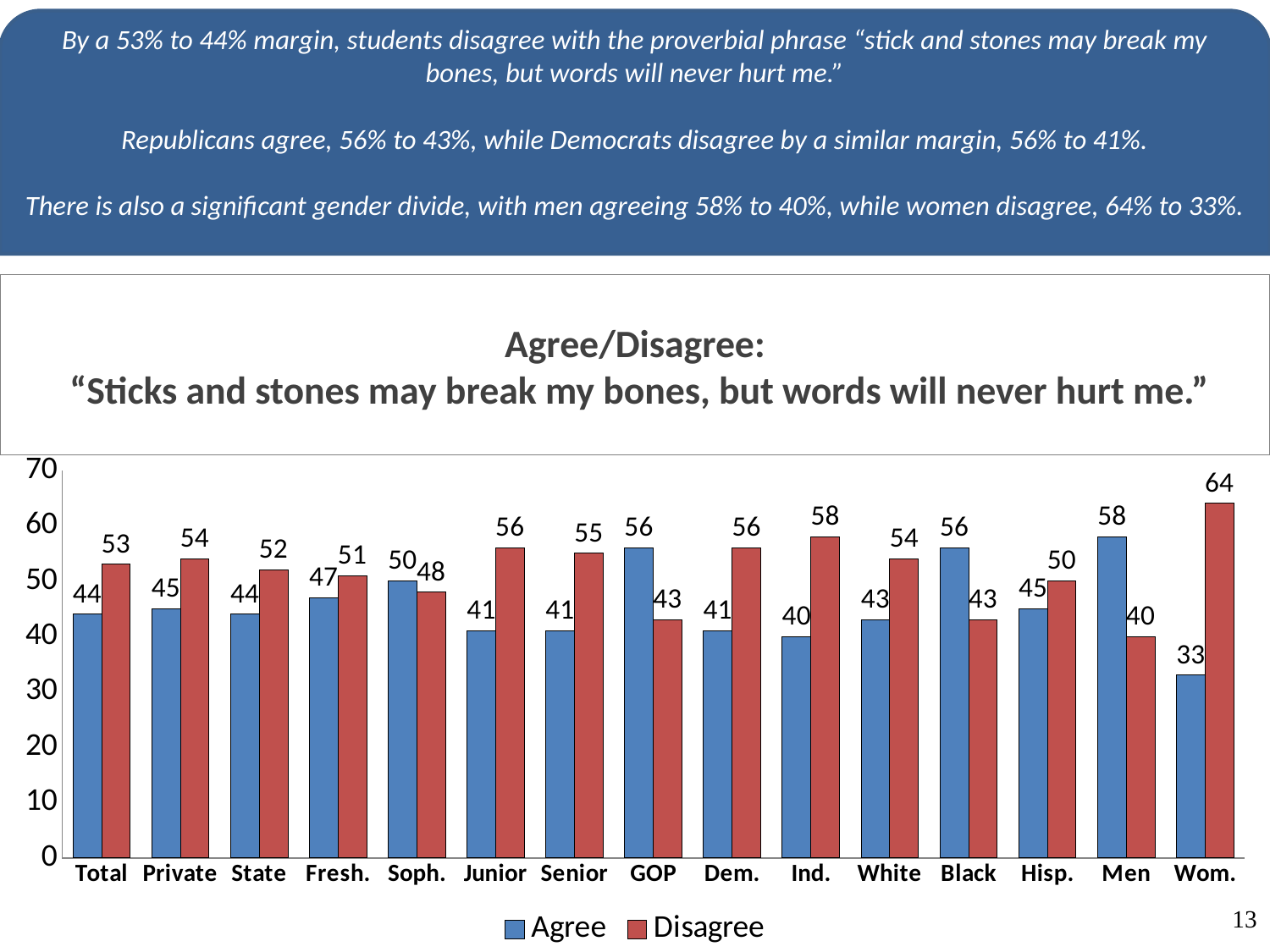
For GOP, which is larger, Agree or Disagree? Agree Which category has the highest Disagree value? Wom. What is the difference between the Disagree and Agree values for Wom.? 31 What is the Disagree value for Wom.? 64 How many categories are shown on the x axis? 15 How many series does the legend list? 2 Which category has the lowest Agree value? Wom. What is the Agree value for Total? 44 What colour are the Disagree bars? red What kind of chart is shown? bar chart What is the Agree value for Men? 58 Is the Agree value for Black greater or less than 50? greater